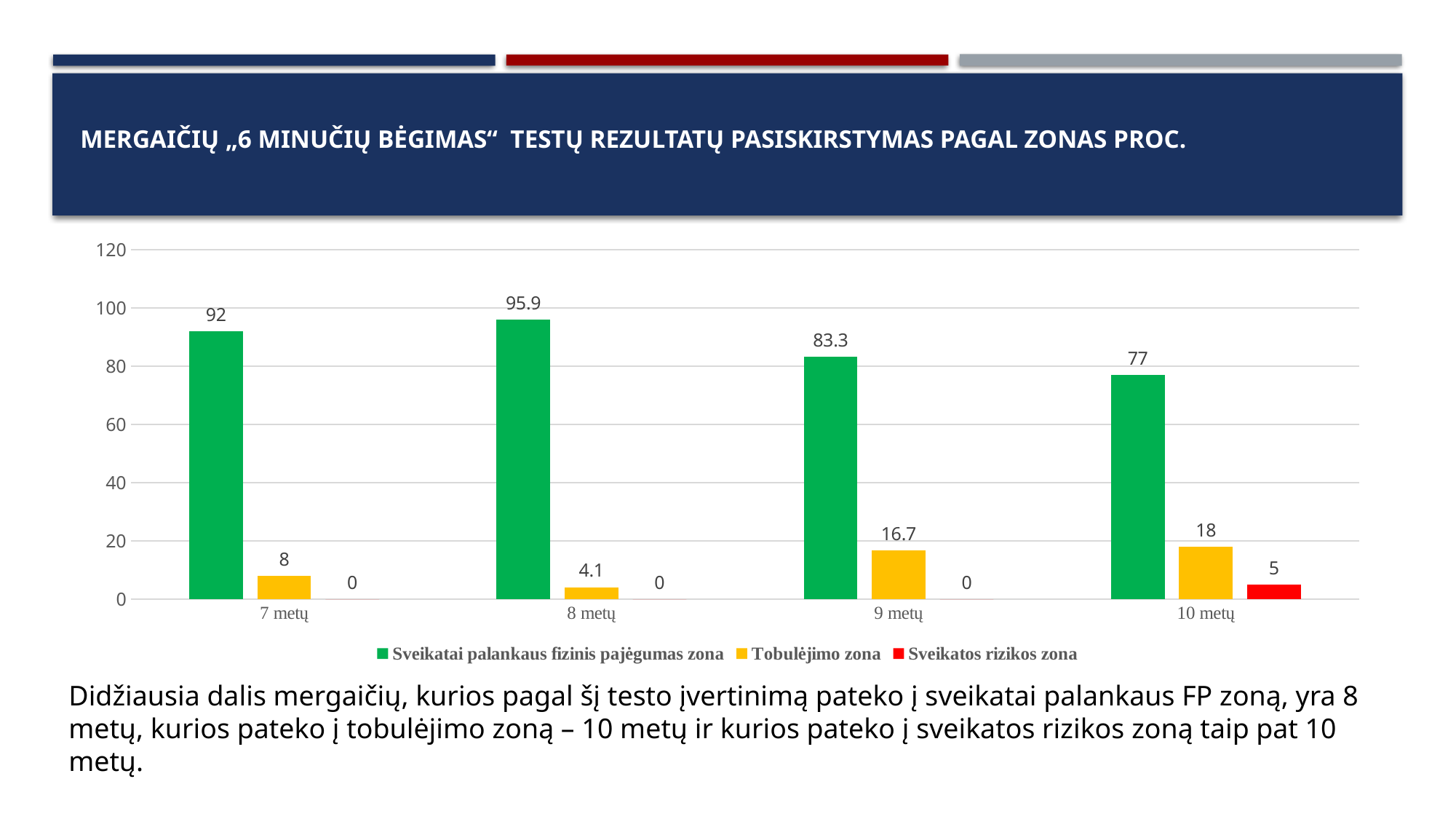
Which is larger: the 'Tobulėjimo zona' value for 7 metų or for 10 metų? 10 metų What is the value for 'Sveikatai palankaus fizinis pajėgumas zona' for 8 metų? 95.9 How many age groups are shown on the x axis? 4 What is the difference between the 'Sveikatai palankaus fizinis pajėgumas zona' values for 7 metų and 10 metų? 15 Which age group has the highest value for 'Sveikatai palankaus fizinis pajėgumas zona'? 8 metų What is the value for 'Tobulėjimo zona' for 9 metų? 16.7 Which age group has the lowest value for 'Sveikatai palankaus fizinis pajėgumas zona'? 10 metų What is the value for 'Sveikatos rizikos zona' for 10 metų? 5 Which colour represents 'Sveikatos rizikos zona' in the chart? Red How many series does the legend list? 3 Does the 'Tobulėjimo zona' value rise or fall from 8 metų to 10 metų? Rise What kind of chart is shown on the slide? Bar chart